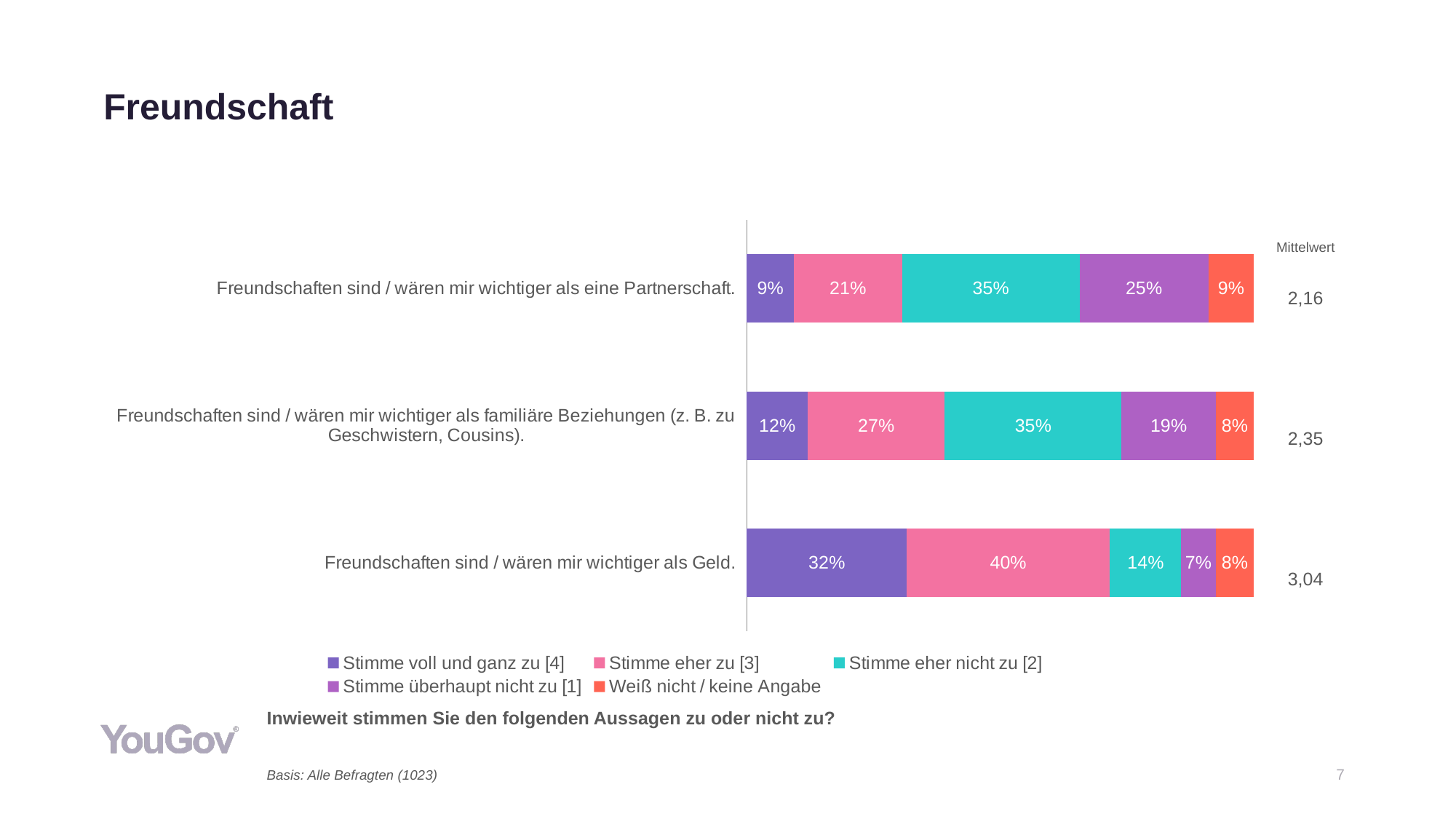
How many statements are shown in the chart? 3 Which statement has the highest share of "Stimme eher zu [3]" responses? Freundschaften sind / wären mir wichtiger als Geld. What is the combined share of "Stimme voll und ganz zu [4]" and "Stimme eher zu [3]" for the Geld statement? 72% Which is larger: the "Stimme eher zu [3]" share for the familiäre Beziehungen statement or for the Partnerschaft statement? familiäre Beziehungen (27%) Which statement has the lowest share of "Stimme voll und ganz zu [4]" responses? Freundschaften sind / wären mir wichtiger als eine Partnerschaft. Which colour represents "Weiß nicht / keine Angabe" in the chart? Orange-red What is the Mittelwert shown for "Freundschaften sind / wären mir wichtiger als familiäre Beziehungen (z. B. zu Geschwistern, Cousins)."? 2,35 What percentage answered "Stimme eher nicht zu [2]" to "Freundschaften sind / wären mir wichtiger als eine Partnerschaft."? 35% What is the difference in "Stimme überhaupt nicht zu [1]" between the Partnerschaft statement and the Geld statement? 18 percentage points What percentage of respondents answered "Stimme voll und ganz zu [4]" to the statement "Freundschaften sind / wären mir wichtiger als Geld."? 32% How many series does the legend list? 5 What kind of chart is shown on the slide? Stacked horizontal bar chart